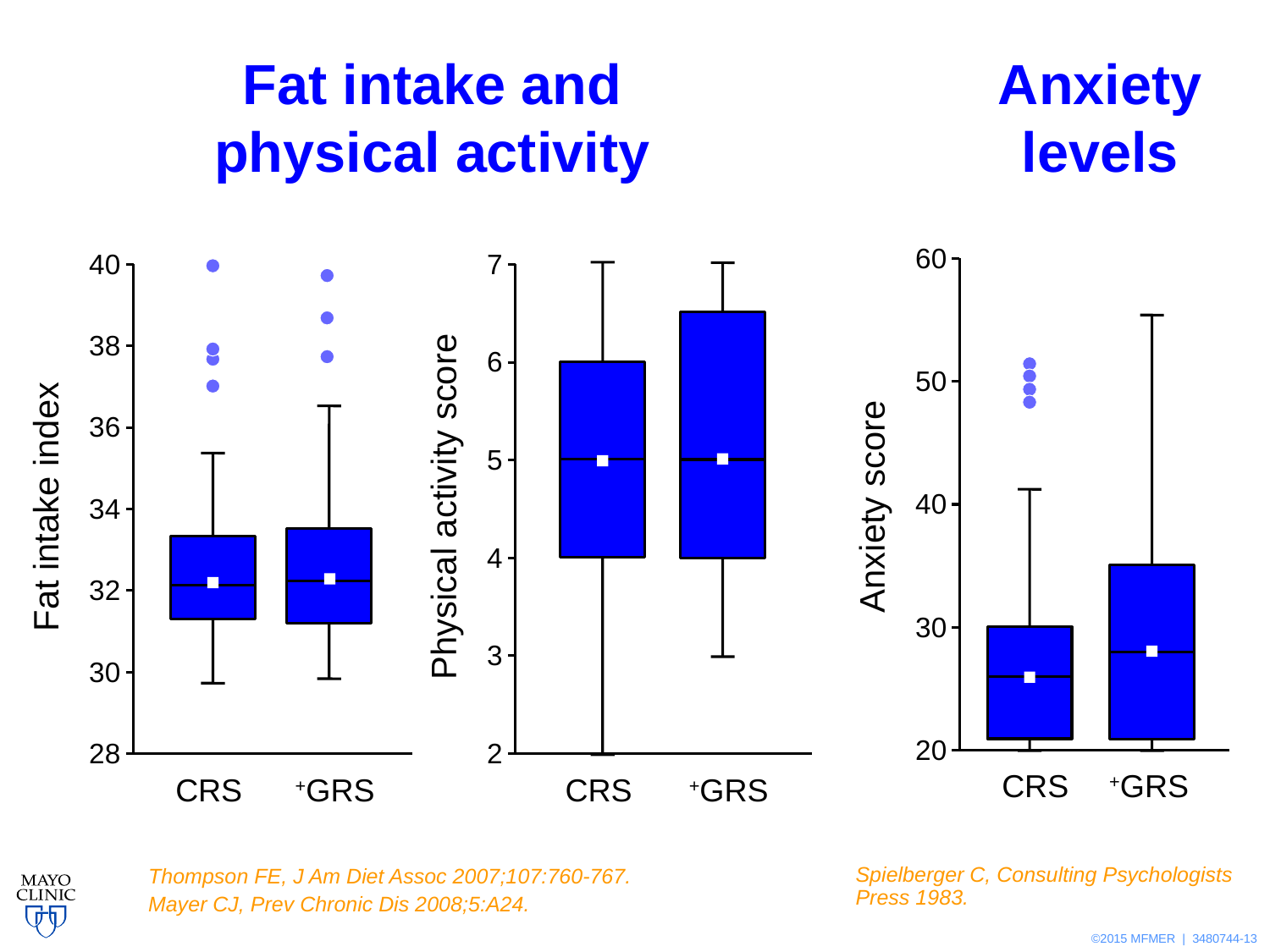
On the Anxiety score chart, is the top of the upper whisker for +GRS greater or less than 50? greater On the Fat intake index chart, is the median for +GRS greater or less than 34? less On the Anxiety score chart, which group has the higher median, CRS or +GRS? +GRS On the Physical activity score chart, is the median for CRS greater or less than 4? greater How many groups are compared on the x axis of the Fat intake index chart? 2 On the Anxiety score chart, which group has the higher upper whisker, CRS or +GRS? +GRS What is the y-axis label of the chart on the right of the slide? Anxiety score On the Physical activity score chart, which group has the higher top of the box, CRS or +GRS? +GRS How many charts are shown on the slide? 3 What kind of chart is the Anxiety score chart on the right of the slide? box plot